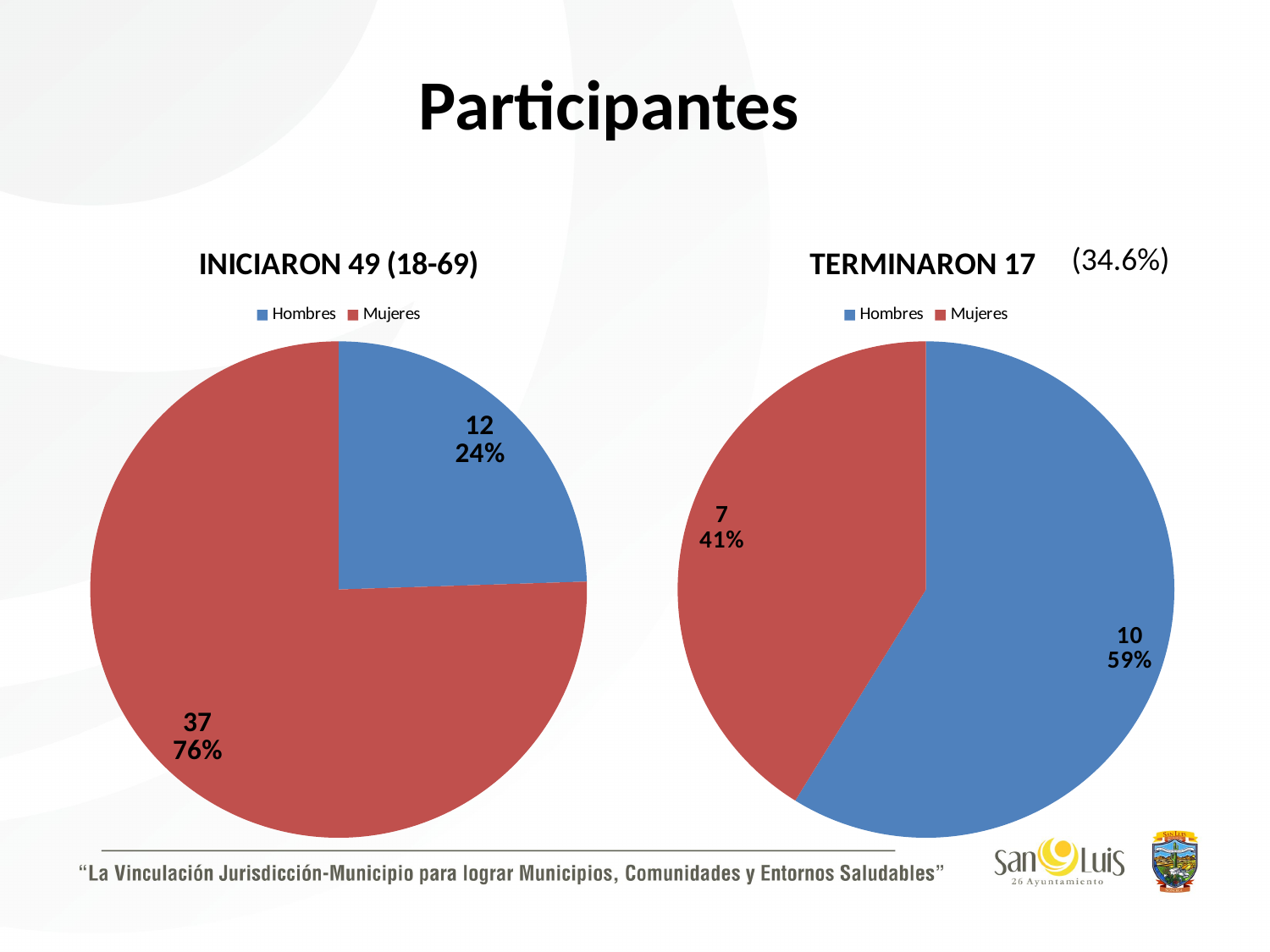
In the 'INICIARON 49 (18-69)' chart, what is the value for Mujeres? 37 In the 'INICIARON 49 (18-69)' chart, what share of the pie is Mujeres? 76% What kind of chart is the 'INICIARON 49 (18-69)' chart? Pie chart In the 'TERMINARON 17' chart, which category is the smallest? Mujeres In the 'TERMINARON 17' chart, what share of the pie is Hombres? 59% In the 'INICIARON 49 (18-69)' chart, what is the value for Hombres? 12 In the 'TERMINARON 17' chart, which is larger, Hombres or Mujeres? Hombres In the 'INICIARON 49 (18-69)' chart, what is the difference between Mujeres and Hombres? 25 How many entries does the legend of the 'TERMINARON 17' chart list? 2 In the 'INICIARON 49 (18-69)' chart, which category is the largest? Mujeres In the 'TERMINARON 17' chart, what is the value for Hombres? 10 In the 'TERMINARON 17' chart, what is the value for Mujeres? 7